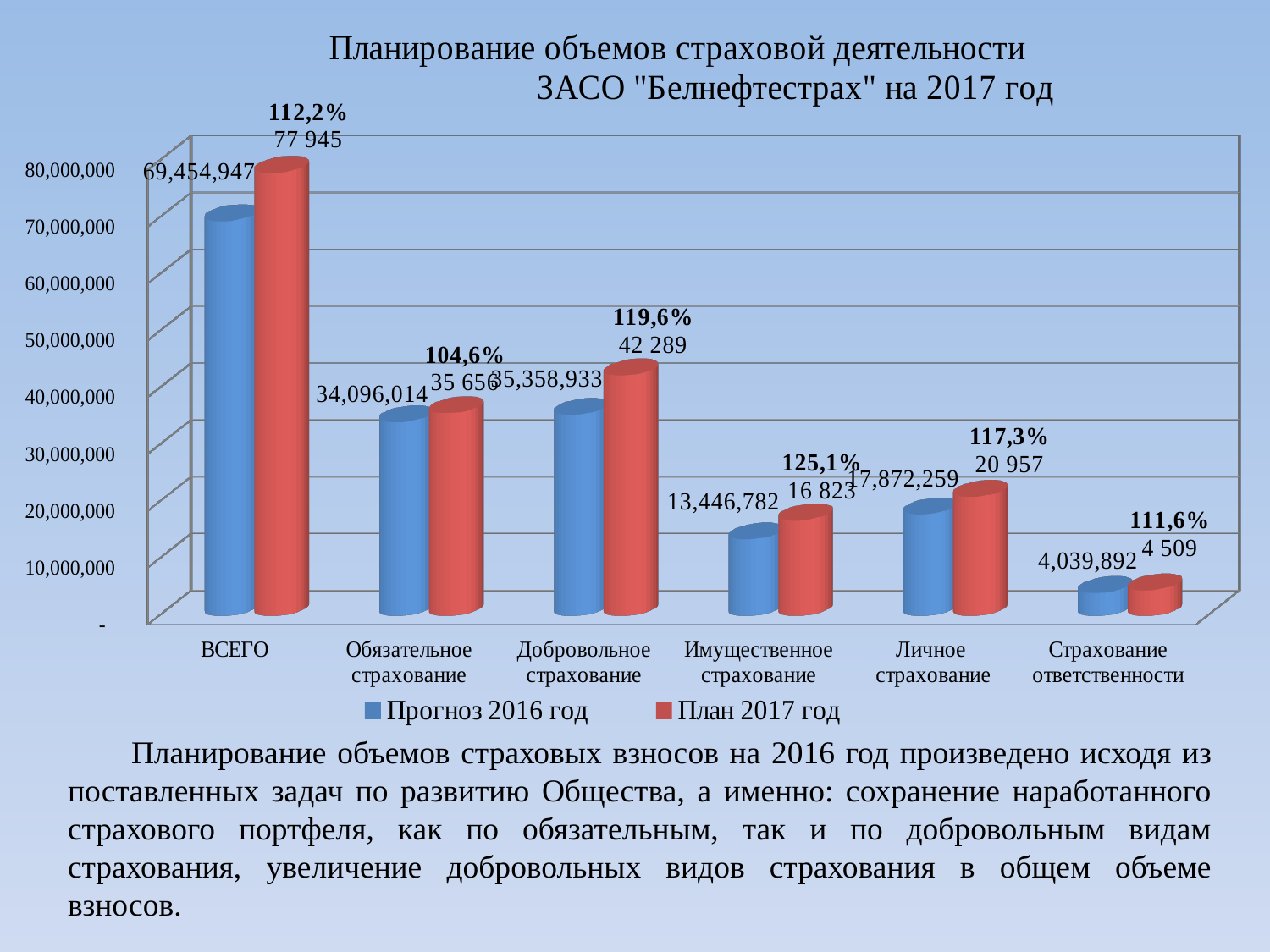
What is the value for Имущественное страхование in the Прогноз 2016 год series? 13,446,782 What kind of chart is shown on the slide? bar chart Is the Прогноз 2016 год value for Обязательное страхование greater or less than 30,000,000? greater What is the difference between the Прогноз 2016 год values for Добровольное страхование and Обязательное страхование? 1,262,919 What is the data label for Добровольное страхование in the План 2017 год series? 42 289 How many categories are shown on the x axis? 6 Which category has the highest value in the Прогноз 2016 год series? ВСЕГО Which is larger in the Прогноз 2016 год series: Личное страхование or Имущественное страхование? Личное страхование What is the value for ВСЕГО in the Прогноз 2016 год series? 69,454,947 Which category has the lowest value in the Прогноз 2016 год series? Страхование ответственности What percentage is shown above the Личное страхование bars? 117,3% How many series does the legend list? 2